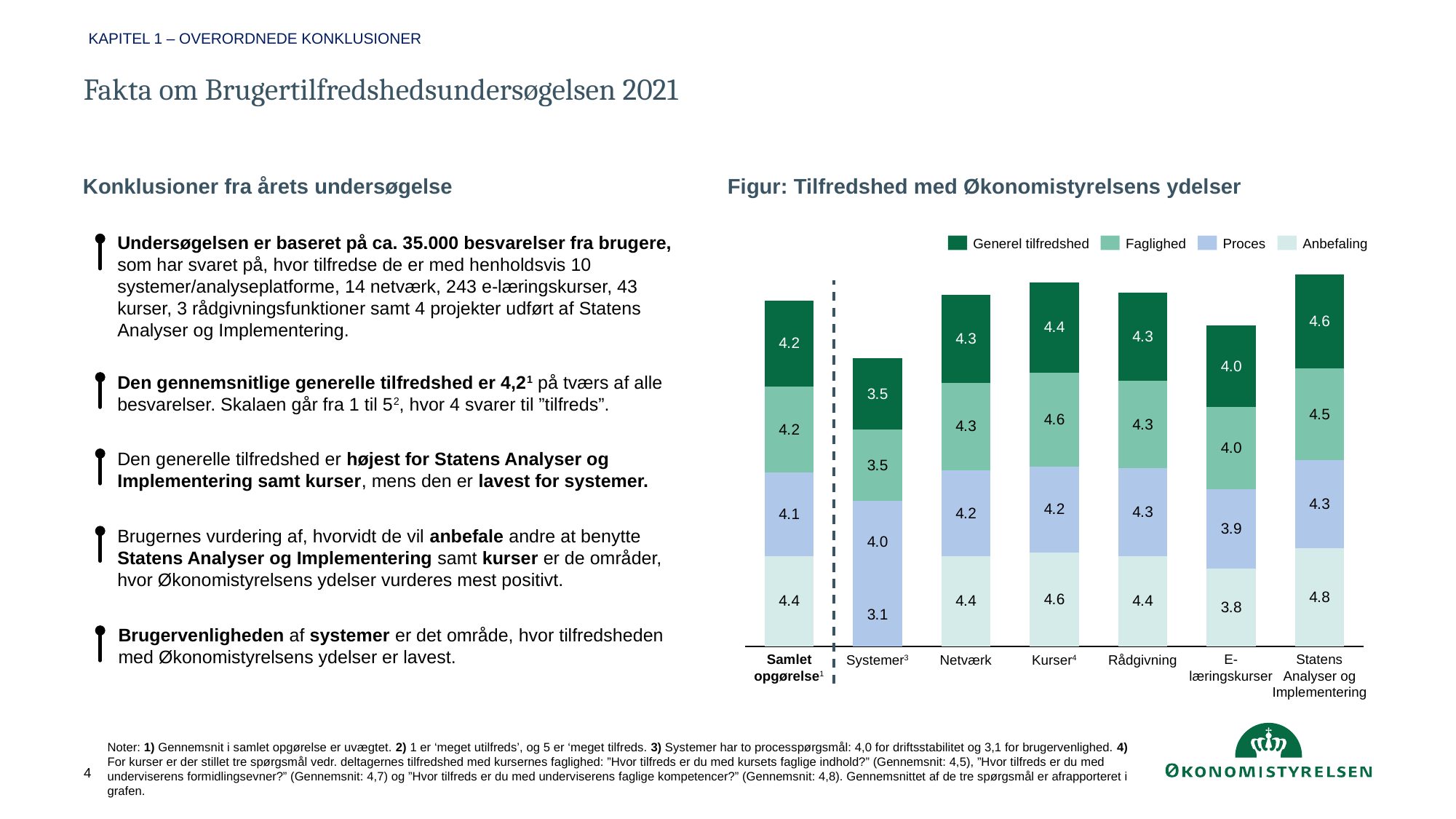
What type of chart is shown on the slide? Stacked bar chart How many series does the legend of the chart list? 4 Which category has the highest Generel tilfredshed value? Statens Analyser og Implementering What is the difference in Generel tilfredshed between Statens Analyser og Implementering and Systemer? 1.1 What is the Anbefaling value for Statens Analyser og Implementering? 4.8 How many categories are shown along the x axis of the chart? 7 What is the Generel tilfredshed value for Kurser? 4.4 Which has the higher Faglighed value, Kurser or Rådgivning? Kurser What is the Faglighed value for Netværk? 4.3 Which category has the lowest Generel tilfredshed value? Systemer What is the Proces value for E-læringskurser? 3.9 What is the title of the chart? Figur: Tilfredshed med Økonomistyrelsens ydelser